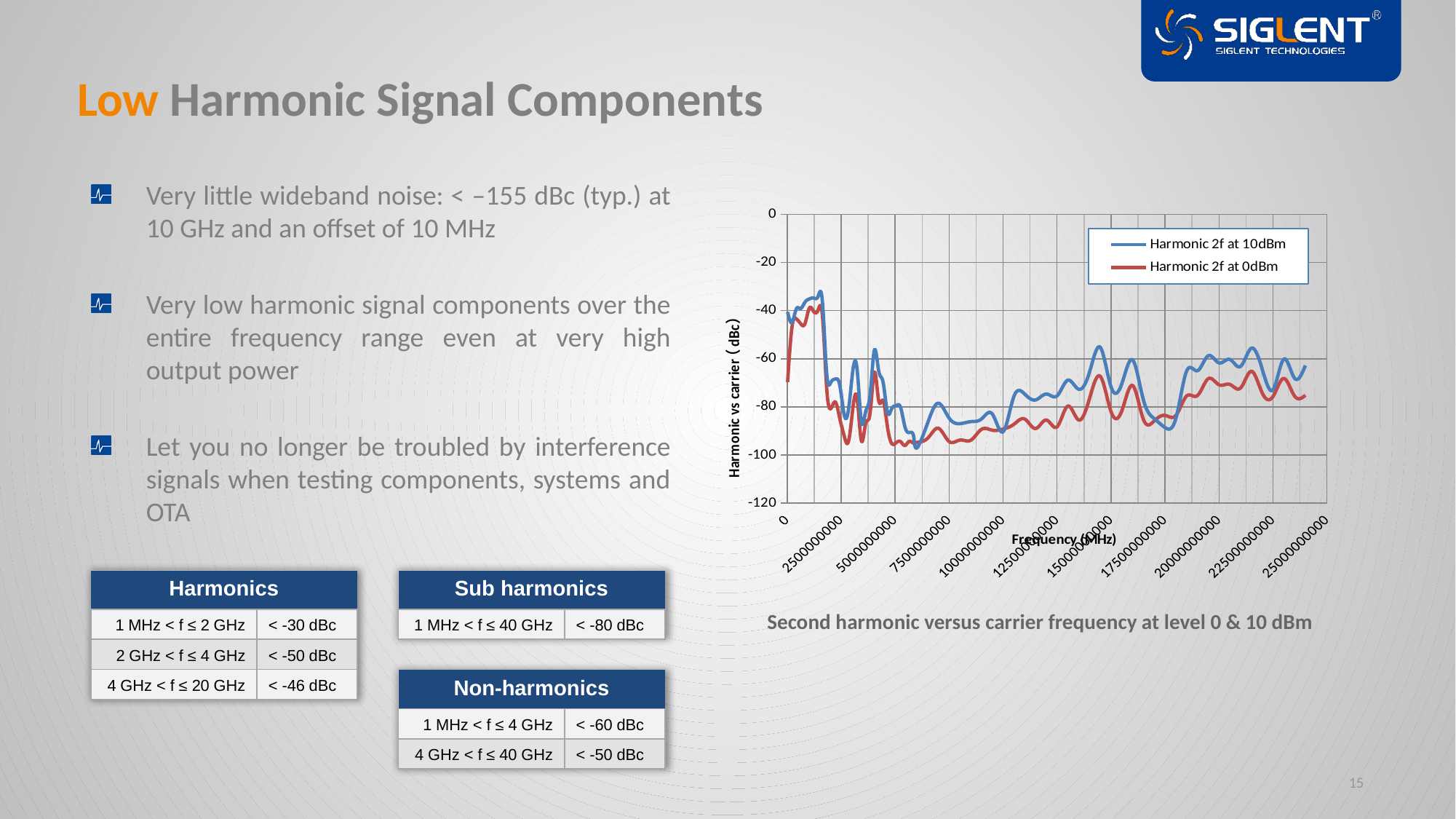
Which series is drawn in red in the chart? Harmonic 2f at 0dBm How many series does the chart legend list? 2 Over most of the frequency range, which series lies higher on the chart: Harmonic 2f at 10dBm or Harmonic 2f at 0dBm? Harmonic 2f at 10dBm What kind of chart is shown on the slide? line chart At 15000000000 MHz, which series has the higher (less negative) value: Harmonic 2f at 10dBm or Harmonic 2f at 0dBm? Harmonic 2f at 10dBm What are the two series named in the chart legend? Harmonic 2f at 10dBm and Harmonic 2f at 0dBm What is the title of the chart's y axis? Harmonic vs carrier (dBc) Is the value of the Harmonic 2f at 0dBm series at 7500000000 MHz greater or less than -80? less Is the value of the Harmonic 2f at 10dBm series at 7500000000 MHz greater or less than -80? less